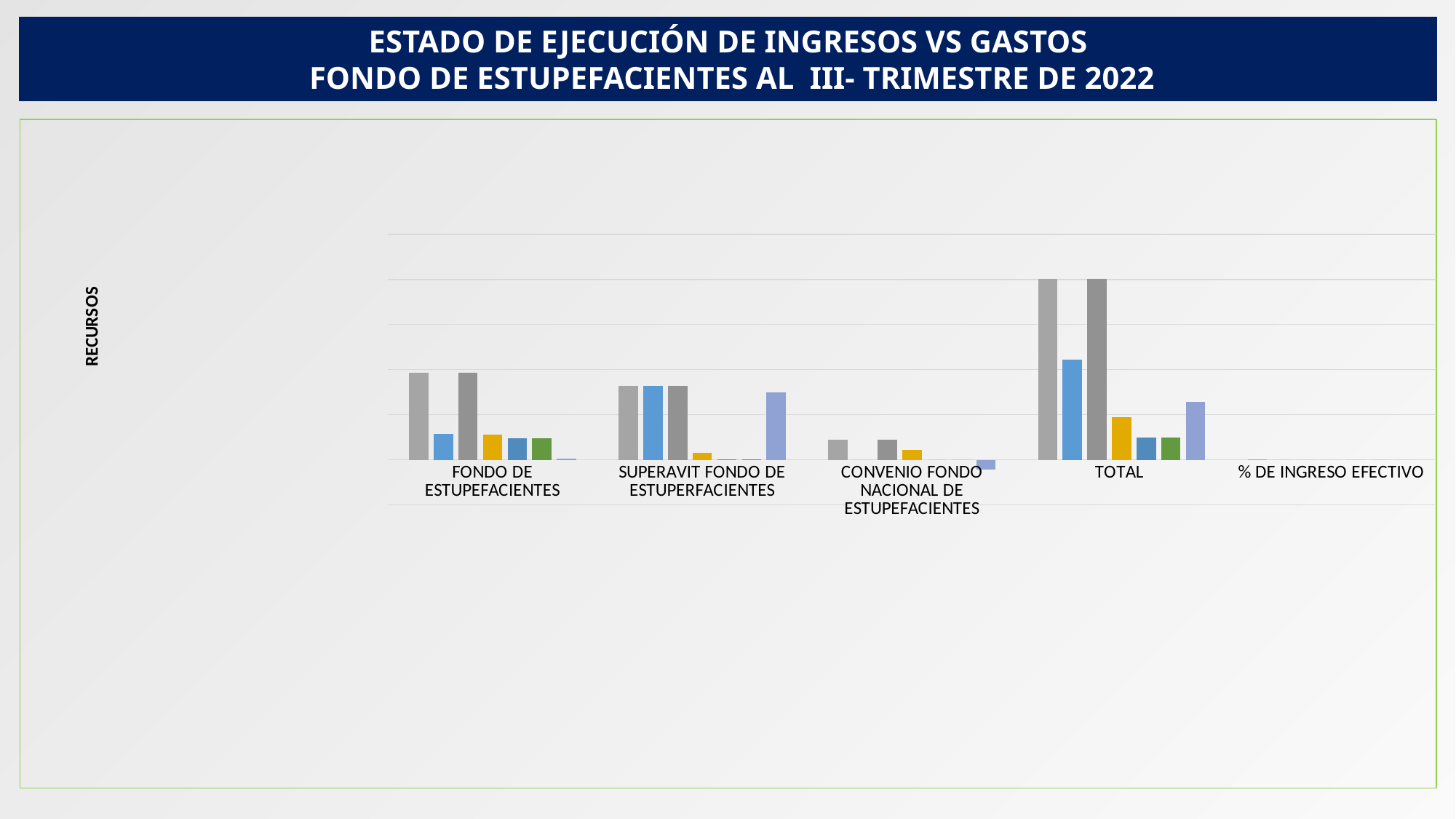
What is the title shown at the top of the slide? ESTADO DE EJECUCIÓN DE INGRESOS VS GASTOS FONDO DE ESTUPEFACIENTES AL III- TRIMESTRE DE 2022 What kind of chart is shown on the slide? Bar chart What is the title of the vertical axis of the chart? RECURSOS How many categories are shown along the x axis of the chart? 5 In the TOTAL category, which is taller: the first gray bar or the blue bar? The first gray bar Which category has the smallest bars in the chart? % DE INGRESO EFECTIVO Which category has taller bars overall: FONDO DE ESTUPEFACIENTES or CONVENIO FONDO NACIONAL DE ESTUPEFACIENTES? FONDO DE ESTUPEFACIENTES Which category has the tallest bars in the chart? TOTAL How many bars are plotted for the TOTAL category? 7